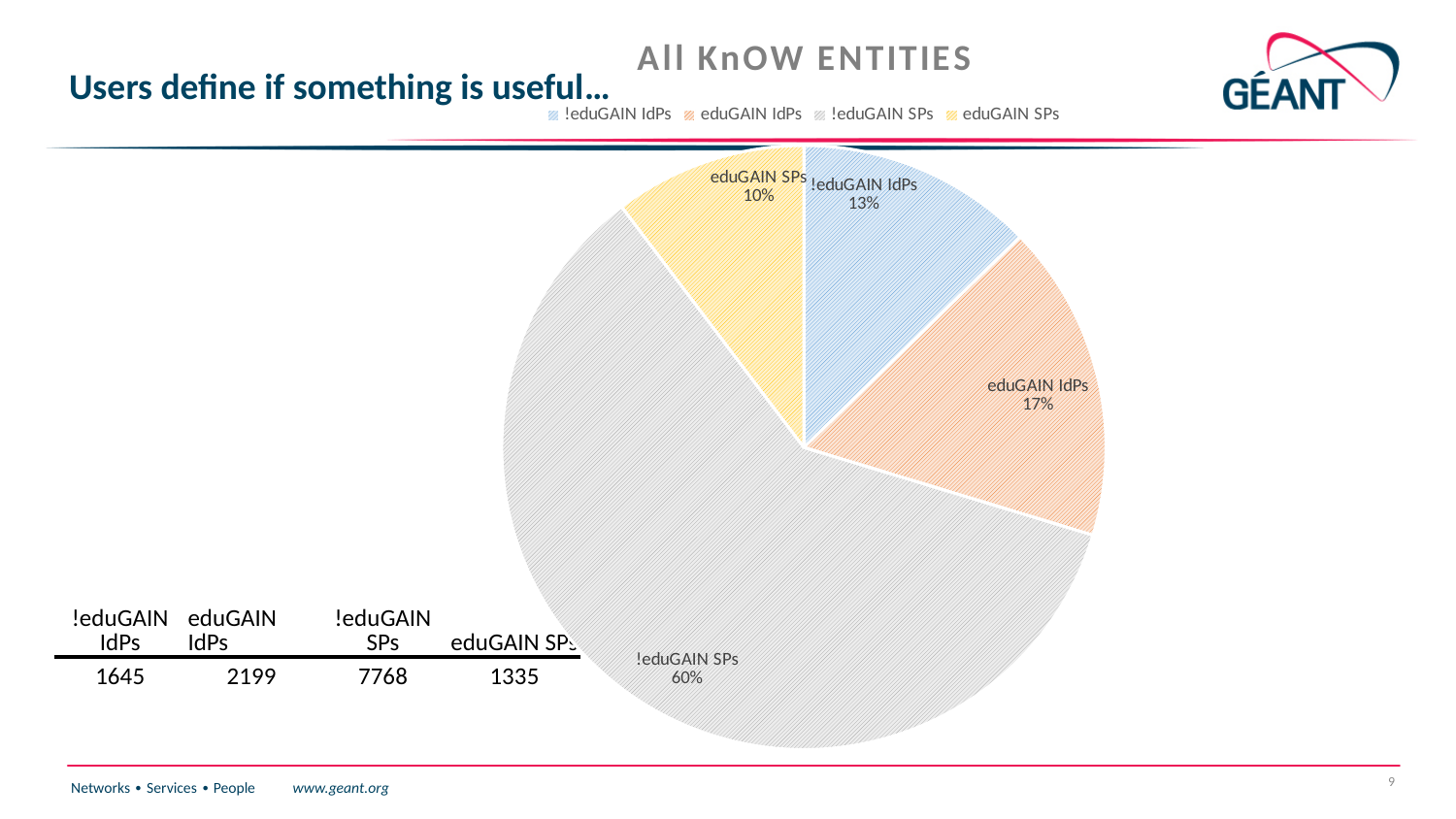
What share of the pie is !eduGAIN SPs? 60% According to the data table, what is the value for !eduGAIN SPs? 7768 Which category has the largest slice of the pie? !eduGAIN SPs What share of the pie is !eduGAIN IdPs? 13% What share of the pie is eduGAIN SPs? 10% What kind of chart is shown on the slide? pie chart Which category has the smallest slice of the pie? eduGAIN SPs How many slices does the pie chart have? 4 What is the title of the chart? All KnOW ENTITIES How many entries does the chart legend list? 4 According to the data table, what is the difference between the values for eduGAIN IdPs and !eduGAIN IdPs? 554